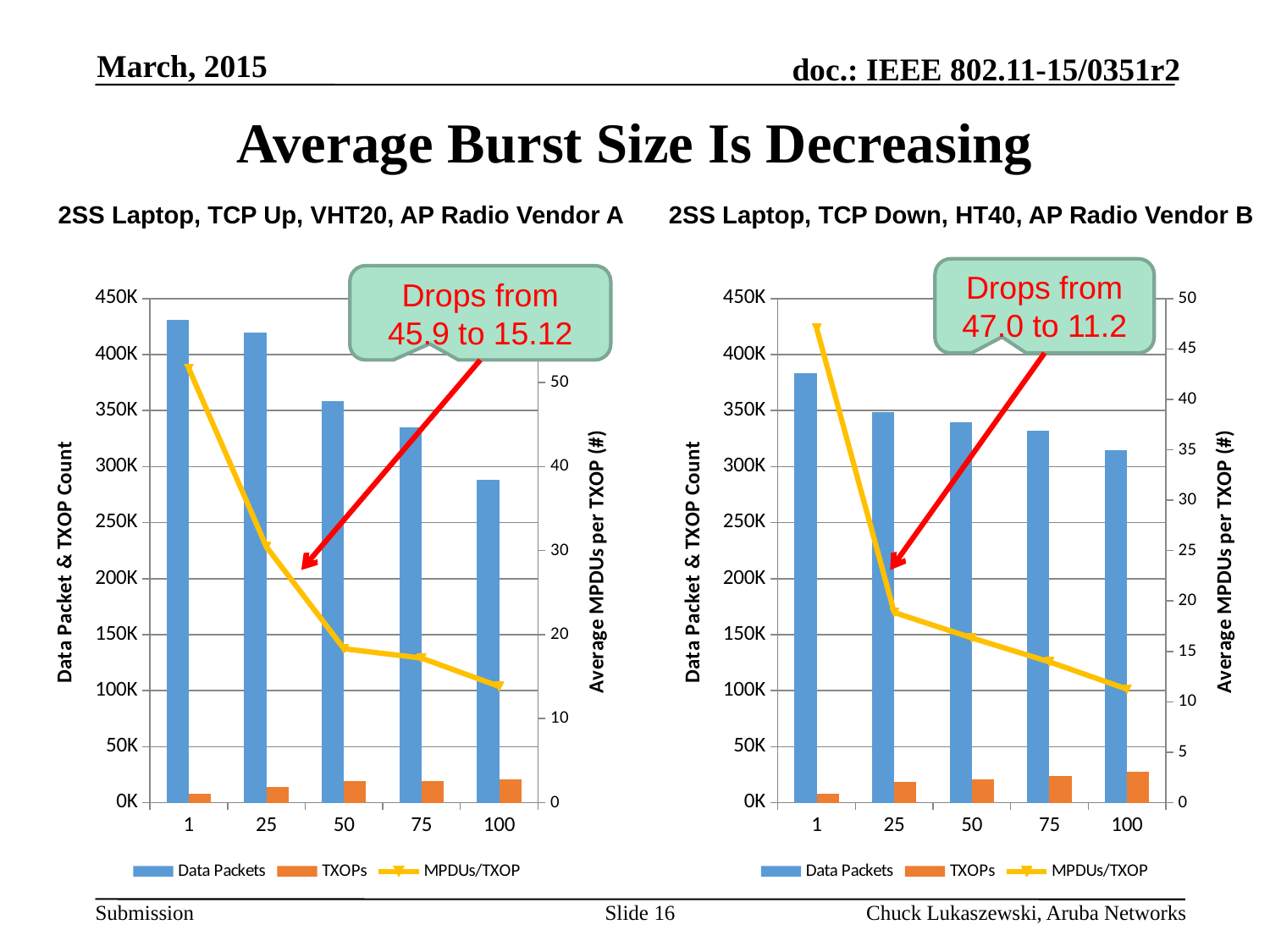
What kind of chart is the left chart titled '2SS Laptop, TCP Up, VHT20, AP Radio Vendor A'? A combined bar and line chart What is the label of the secondary (right-hand) y axis on the left chart ('TCP Up, VHT20, Vendor A')? Average MPDUs per TXOP (#) In the right chart ('TCP Down, HT40, Vendor B'), is the Data Packets value for category 100 greater or less than 350K? less In the left chart ('TCP Up, VHT20, Vendor A'), which category has the highest Data Packets bar? 1 How many categories are shown on the x axis of the left chart ('TCP Up, VHT20, Vendor A')? 5 In the left chart ('TCP Up, VHT20, Vendor A'), does the MPDUs/TXOP line rise or fall as the x axis goes from 1 to 100? Fall What does the callout on the right chart ('TCP Down, HT40, Vendor B') say? Drops from 47.0 to 11.2 In the left chart ('TCP Up, VHT20, Vendor A'), is the Data Packets value for category 1 greater or less than 400K? greater In the left chart ('TCP Up, VHT20, Vendor A'), is the Data Packets value for category 25 larger or smaller than the value for category 50? larger In the right chart ('TCP Down, HT40, Vendor B'), which category has the highest TXOPs bar? 100 How many series does the legend of the right chart ('2SS Laptop, TCP Down, HT40, AP Radio Vendor B') list? 3 In the left chart ('TCP Up, VHT20, Vendor A'), which category has the lowest Data Packets bar? 100